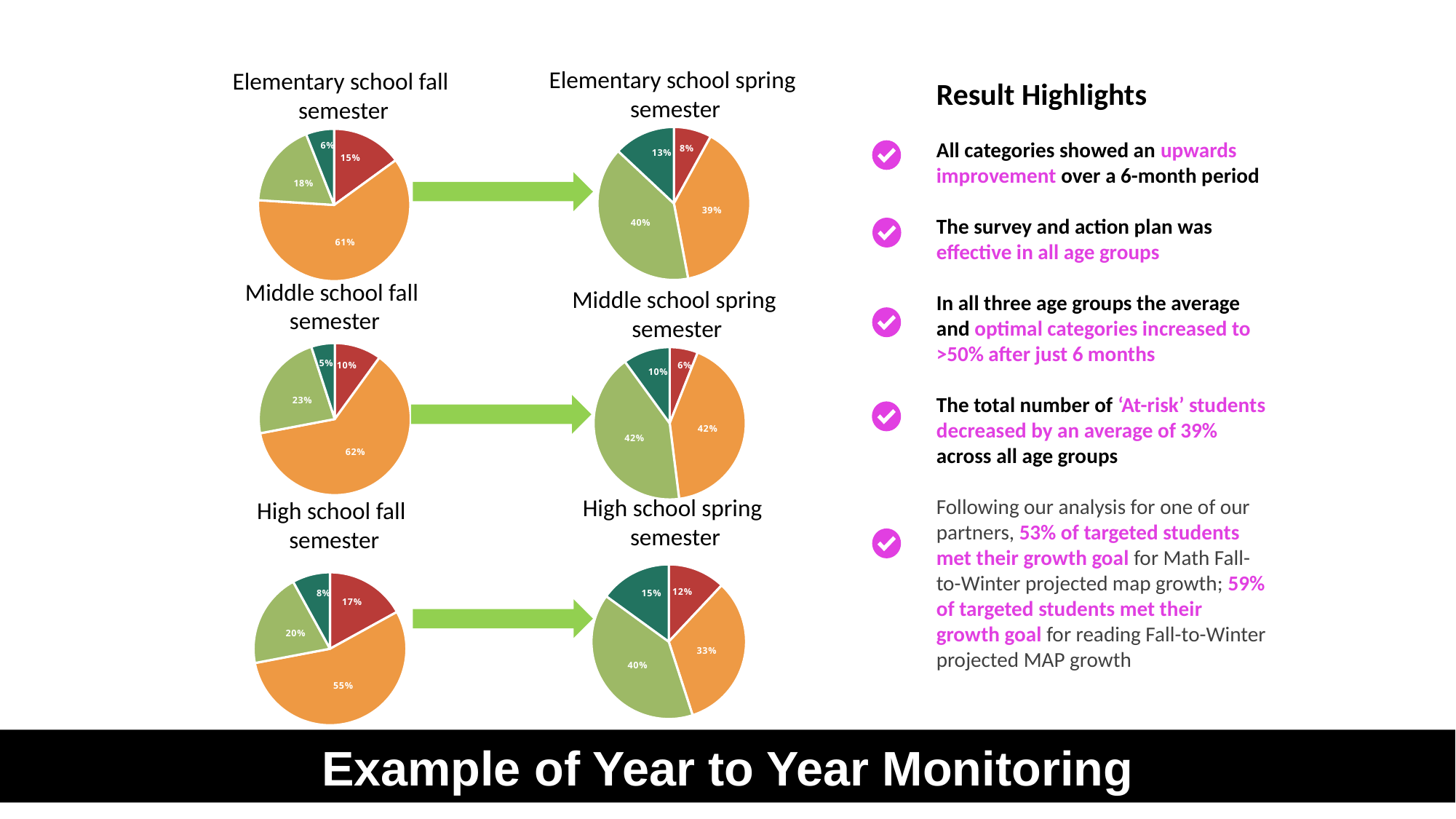
In the 'High school spring semester' pie chart, what percentage is shown on the red slice? 12% What is the difference between the orange slice in the 'Elementary school fall semester' chart (61%) and the orange slice in the 'Elementary school spring semester' chart (39%)? 22 percentage points How many slices does the 'Middle school spring semester' pie chart have? 4 In the 'Elementary school spring semester' pie chart, what percentage is shown on the dark green slice? 13% In the 'Middle school fall semester' pie chart, which slice is the smallest? The dark green slice (5%) In the 'Middle school fall semester' pie chart, what percentage is shown on the light green slice? 23% In the 'Middle school spring semester' pie chart, what percentage is shown on the orange slice? 42% What kind of chart is used for the 'Elementary school fall semester' data? Pie chart In the 'High school fall semester' pie chart, which slice is the largest? The orange slice (55%) In the 'Elementary school fall semester' pie chart, what percentage is shown on the orange slice? 61% Which is larger: the red slice in the 'High school fall semester' chart or the red slice in the 'High school spring semester' chart? High school fall semester (17%) How many pie charts are shown on the slide? 6